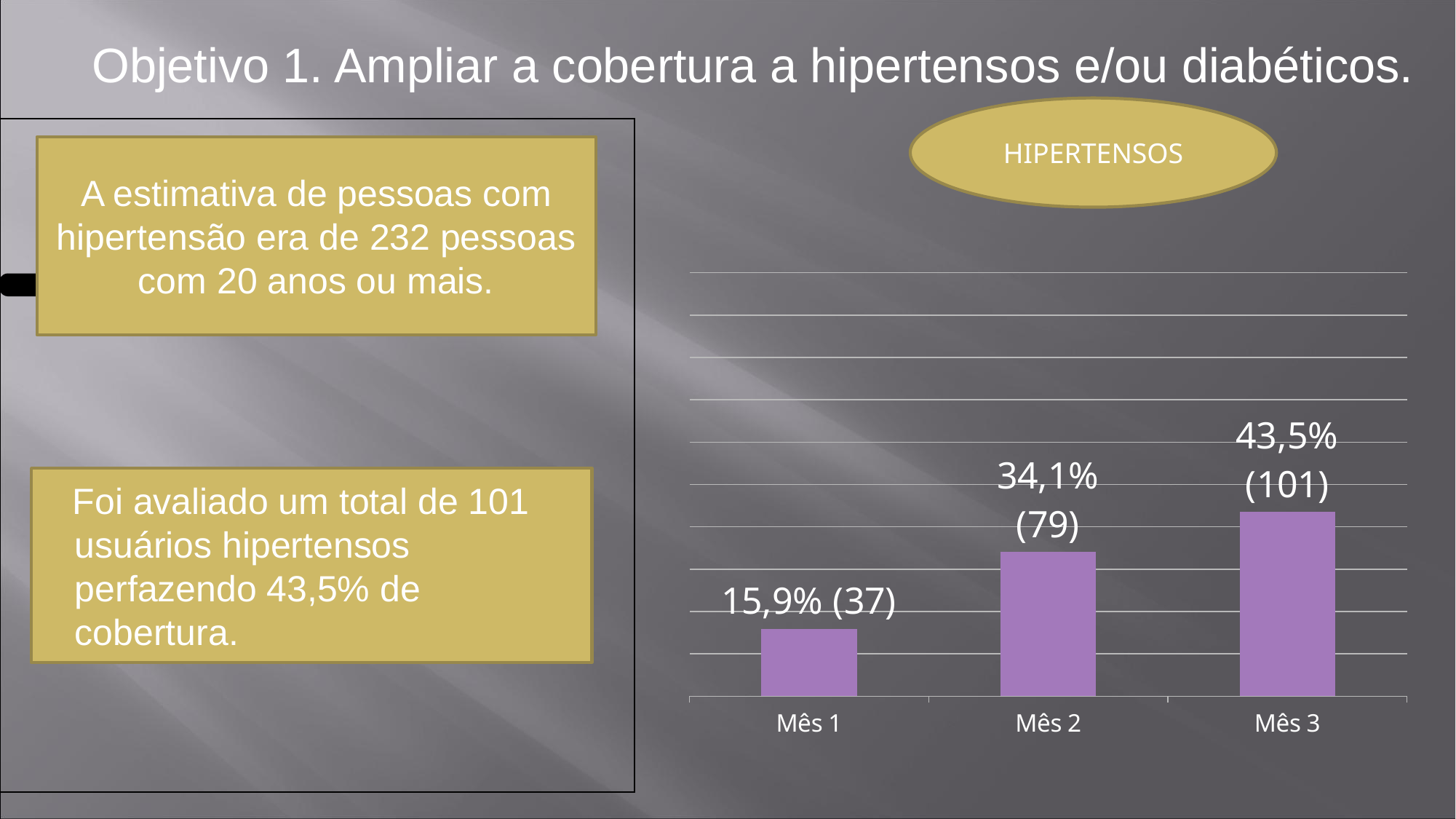
What is the difference in percentage points between Mês 3 and Mês 2? 9,4 What is the data label shown for Mês 1? 15,9% (37) What percentage is shown for Mês 2? 34,1% Which is larger, the value for Mês 1 or the value for Mês 2? Mês 2 Do the values rise or fall from Mês 1 to Mês 3? Rise Which month has the highest bar? Mês 3 Which month has the lowest bar? Mês 1 What title is shown in the oval above the chart? HIPERTENSOS How many months (categories) are shown on the chart? 3 What is the difference between the counts in parentheses for Mês 2 and Mês 1? 42 What kind of chart is shown on the slide? Bar chart What is the number in parentheses shown for Mês 3? 101